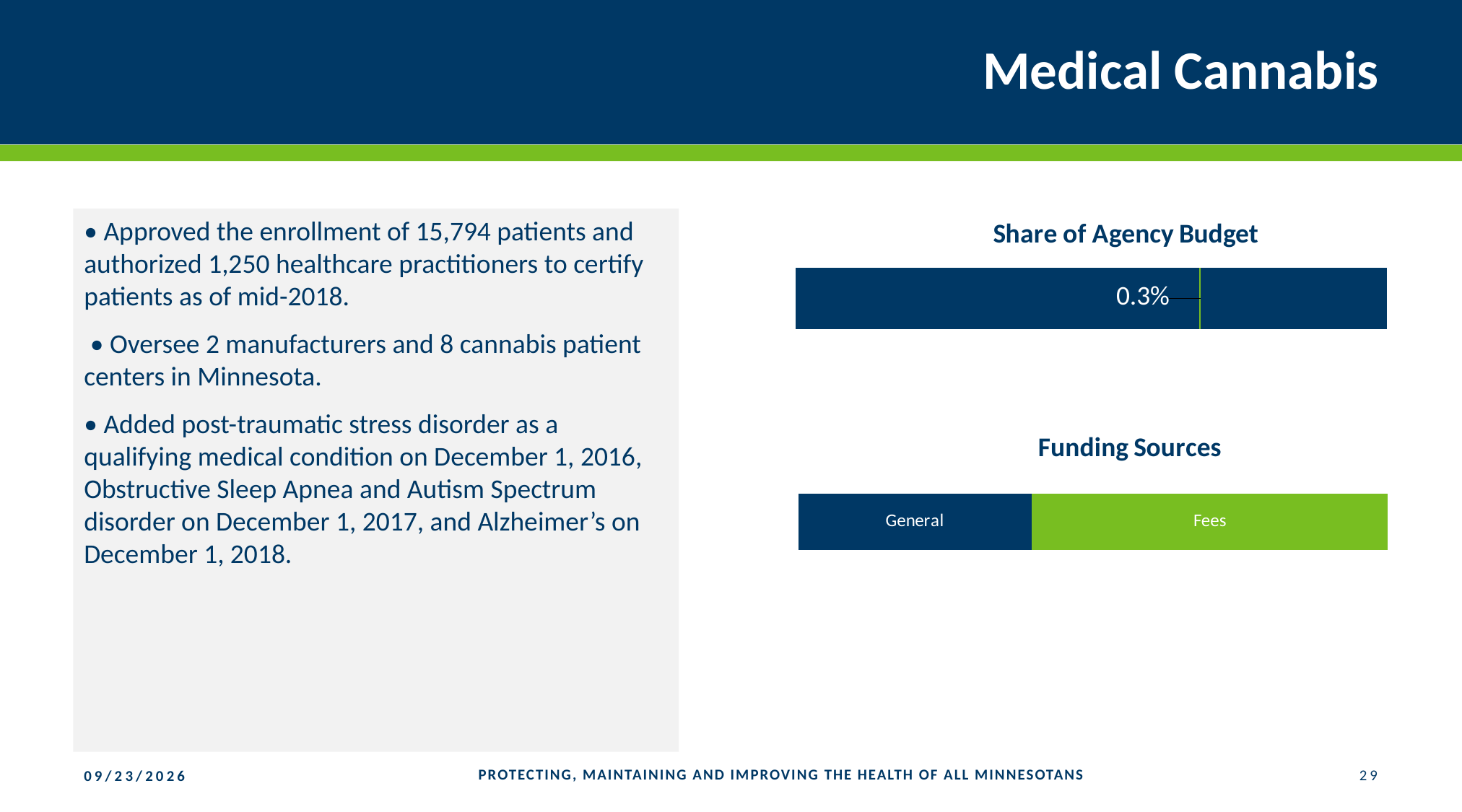
In the Share of Agency Budget chart, is the labeled share greater or less than 1%? less What kind of chart is the Share of Agency Budget chart? Bar chart In the Funding Sources chart, which funding source has the largest share? Fees In the Funding Sources chart, which segment is larger, General or Fees? Fees What is the title of the lower chart on the slide? Funding Sources In the Funding Sources chart, which funding source has the smallest share? General What is the title of the upper chart on the slide? Share of Agency Budget In the Funding Sources chart, how many funding source segments are shown in the bar? 2 What kind of chart is the Funding Sources chart? Stacked bar chart In the Share of Agency Budget chart, what share of the agency budget is shown by the data label? 0.3%